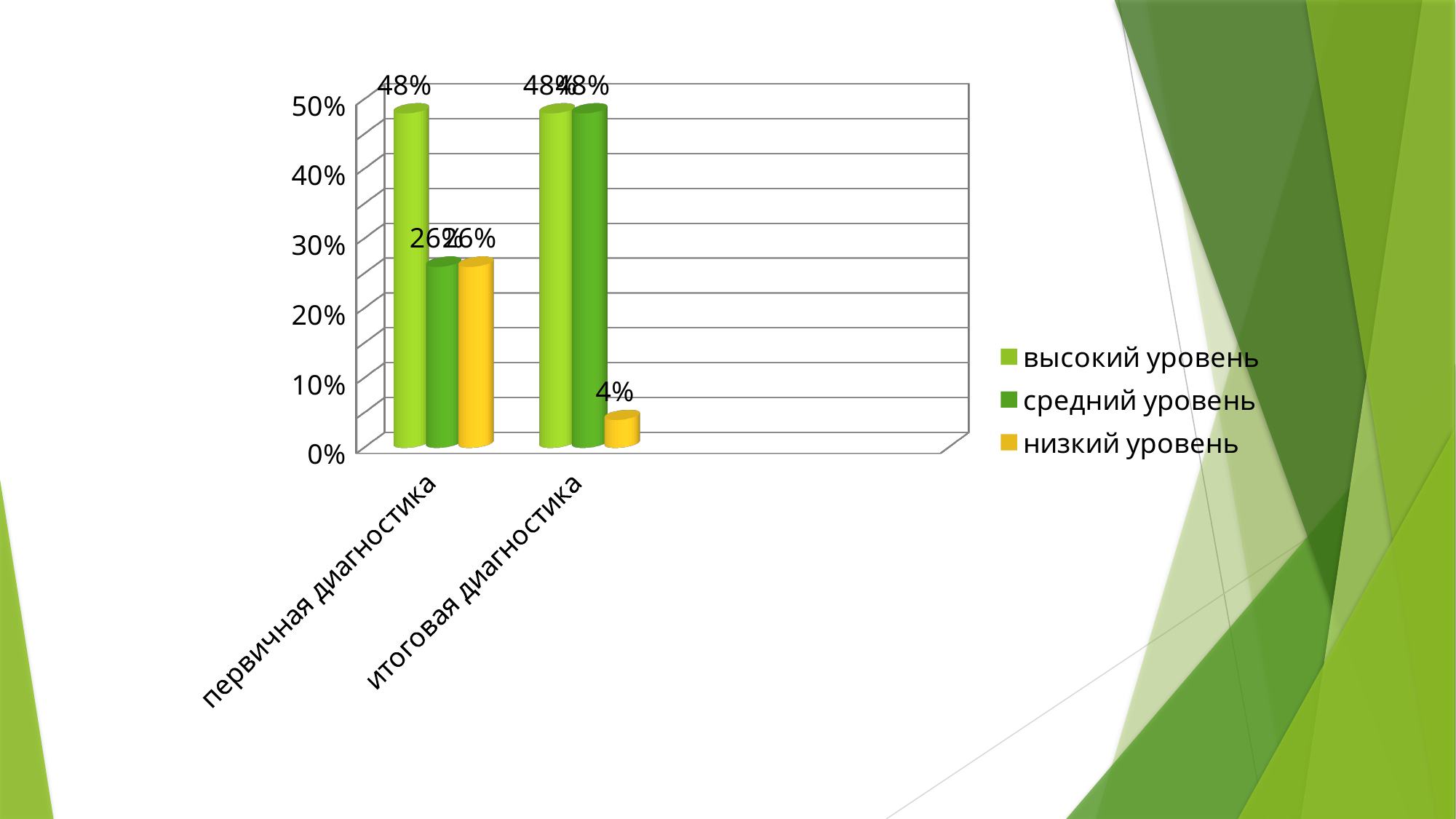
Which series has the lowest value in итоговая диагностика? низкий уровень What kind of chart is shown on the slide? bar chart Which legend entry is shown in yellow? низкий уровень What is the difference between низкий уровень in первичная диагностика and низкий уровень in итоговая диагностика? 22% What is the value for низкий уровень in первичная диагностика? 26% What is the value for средний уровень in итоговая диагностика? 48% How many series does the legend list? 3 What is the value for низкий уровень in итоговая диагностика? 4% Which series has the highest value in первичная диагностика? высокий уровень Which is larger: средний уровень in первичная диагностика or средний уровень in итоговая диагностика? итоговая диагностика What is the value for высокий уровень in первичная диагностика? 48% How many categories are shown on the x axis? 2